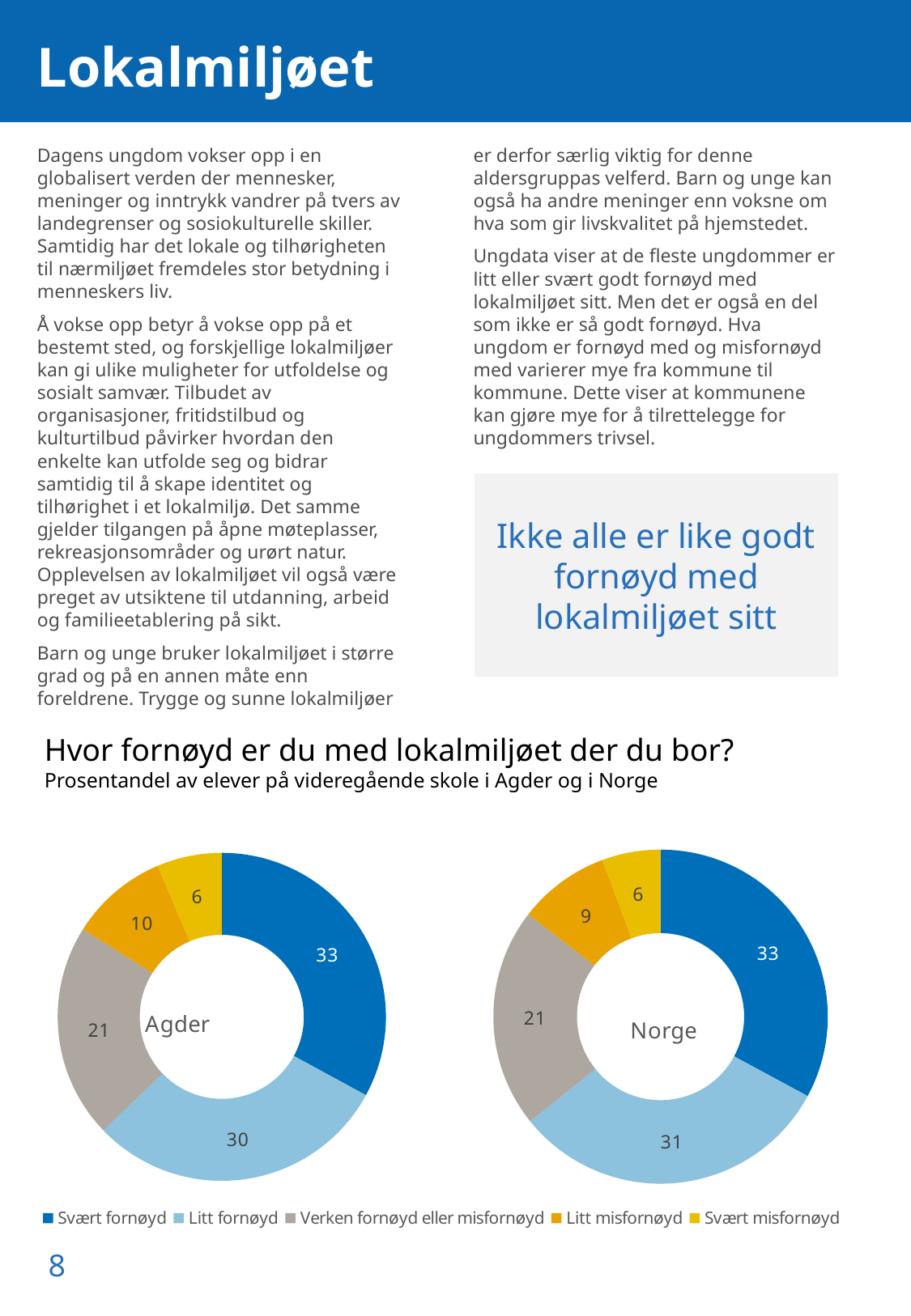
In the Norge chart, what percentage of students answered "Litt fornøyd"? 31 How many entries does the legend list? 5 In the Agder chart, what percentage of students answered "Svært fornøyd"? 33 In the Norge chart, what is the value for "Verken fornøyd eller misfornøyd"? 21 In the Agder chart, what is the difference between the "Svært fornøyd" and "Litt fornøyd" values? 3 What kind of chart is used to show the Agder and Norge data? Donut (pie) chart Which is larger: "Litt misfornøyd" in the Agder chart or "Litt misfornøyd" in the Norge chart? Agder In the Agder chart, what is the value for "Litt misfornøyd"? 10 In the Agder chart, which category has the largest share? Svært fornøyd In the Norge chart, which category has the smallest share? Svært misfornøyd What is the title of the chart section on the slide? Hvor fornøyd er du med lokalmiljøet der du bor? How many categories does each donut chart show? 5